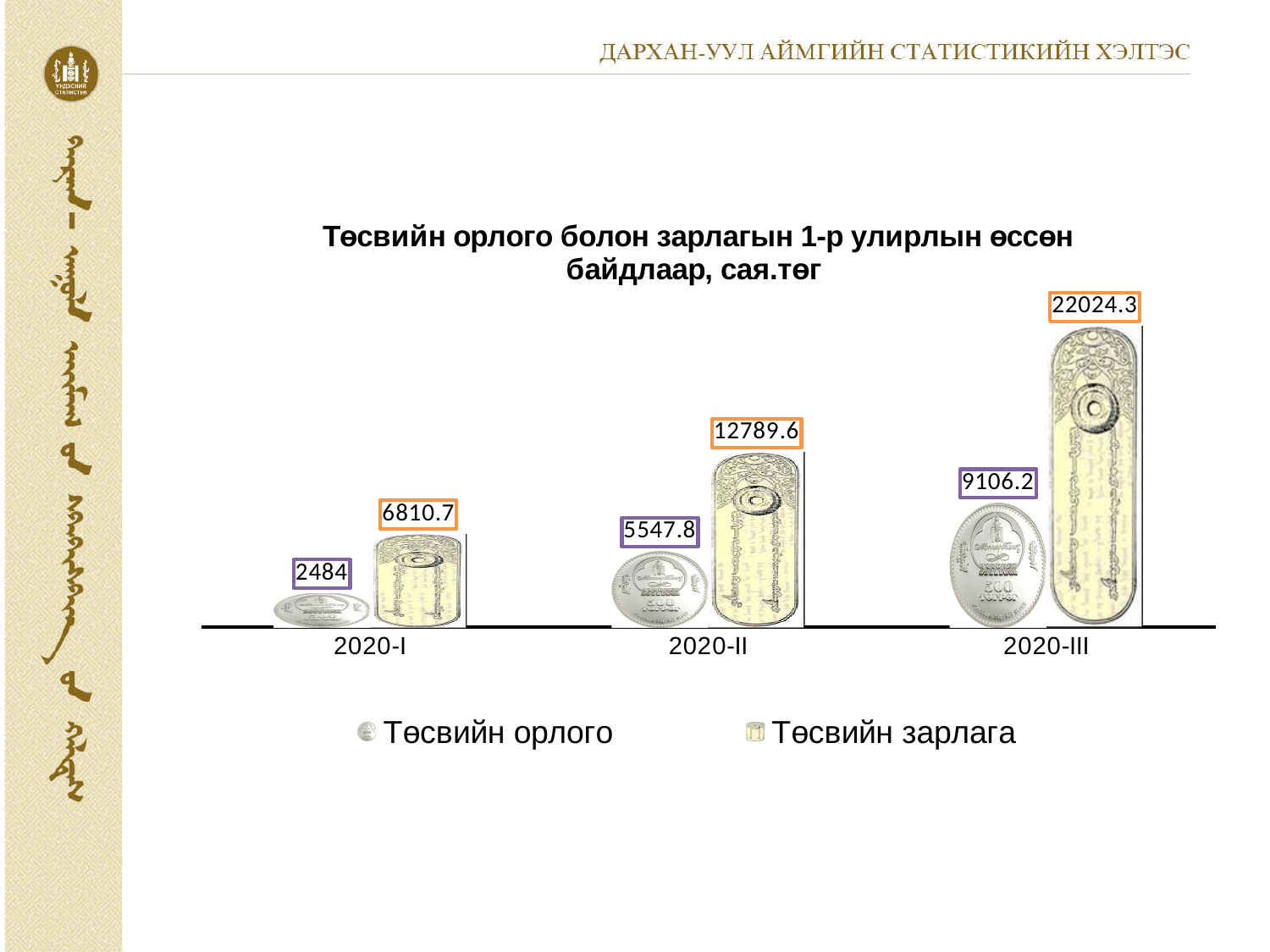
What is the difference between Төсвийн орлого in 2020-III and in 2020-I? 6622.2 What is the value of Төсвийн зарлага for 2020-III? 22024.3 What is the value of Төсвийн орлого for 2020-I? 2484 How many periods are shown on the x axis? 3 Which period has the highest value for Төсвийн зарлага? 2020-III Do the values for Төсвийн орлого rise or fall from 2020-I to 2020-III? rise What is the difference between Төсвийн зарлага and Төсвийн орлого in 2020-III? 12918.1 Which period has the lowest value for Төсвийн орлого? 2020-I In 2020-II, which is larger: Төсвийн орлого or Төсвийн зарлага? Төсвийн зарлага How many series does the legend list? 2 What is the value of Төсвийн орлого for 2020-III? 9106.2 What is the value of Төсвийн зарлага for 2020-II? 12789.6